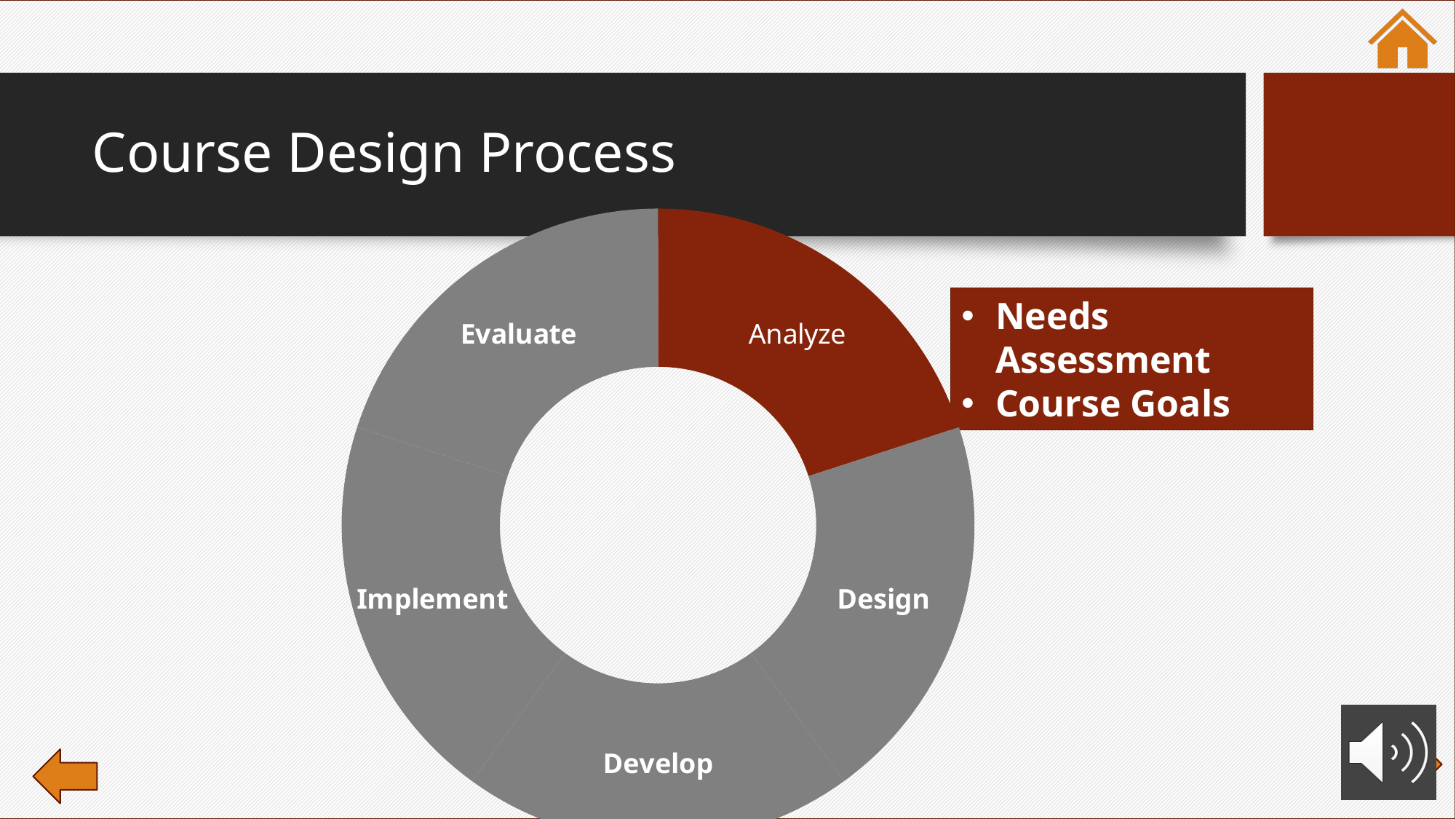
Which segment of the chart is labelled between Evaluate and Design going clockwise? Analyze How many segments does the doughnut chart have? 5 Which segment of the chart is labelled at the bottom? Develop What kind of chart is shown on the slide? Doughnut chart Which segment of the chart is labelled on the left side? Implement Which segment of the chart is labelled on the right side? Design Which segment of the chart is labelled at the top left? Evaluate What is the title of the slide containing the chart? Course Design Process Which segment of the doughnut chart is highlighted in dark red? Analyze